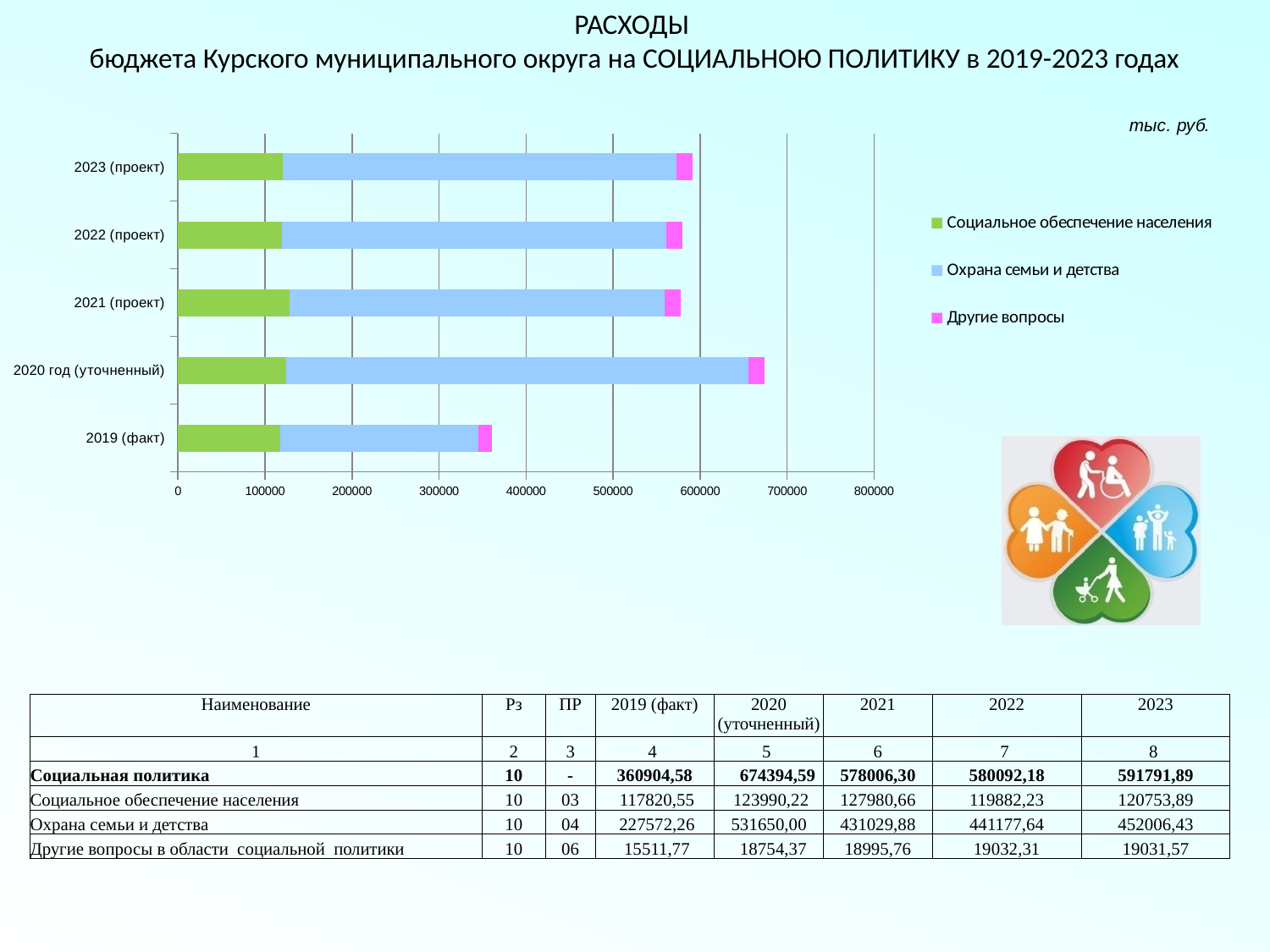
What is the total of the stacked bar for 2021 (проект), as given in the table row Социальная политика? 578006,30 Is the total length of the bar for 2020 год (уточненный) greater or less than 600000? greater Is the total length of the bar for 2019 (факт) greater or less than 400000? less How many series does the chart legend list? 3 How many year categories are plotted on the chart? 5 In 2019 (факт), which segment is larger: Охрана семьи и детства or Социальное обеспечение населения? Охрана семьи и детства According to the table, what is the value for Социальное обеспечение населения in 2023? 120753,89 What kind of chart is shown on the slide? bar chart Which year has the longest total bar on the chart? 2020 год (уточненный) Which series is shown in green in the chart legend? Социальное обеспечение населения According to the table, what is the value for Охрана семьи и детства in 2020 (уточненный)? 531650,00 Which year has the shortest total bar on the chart? 2019 (факт)